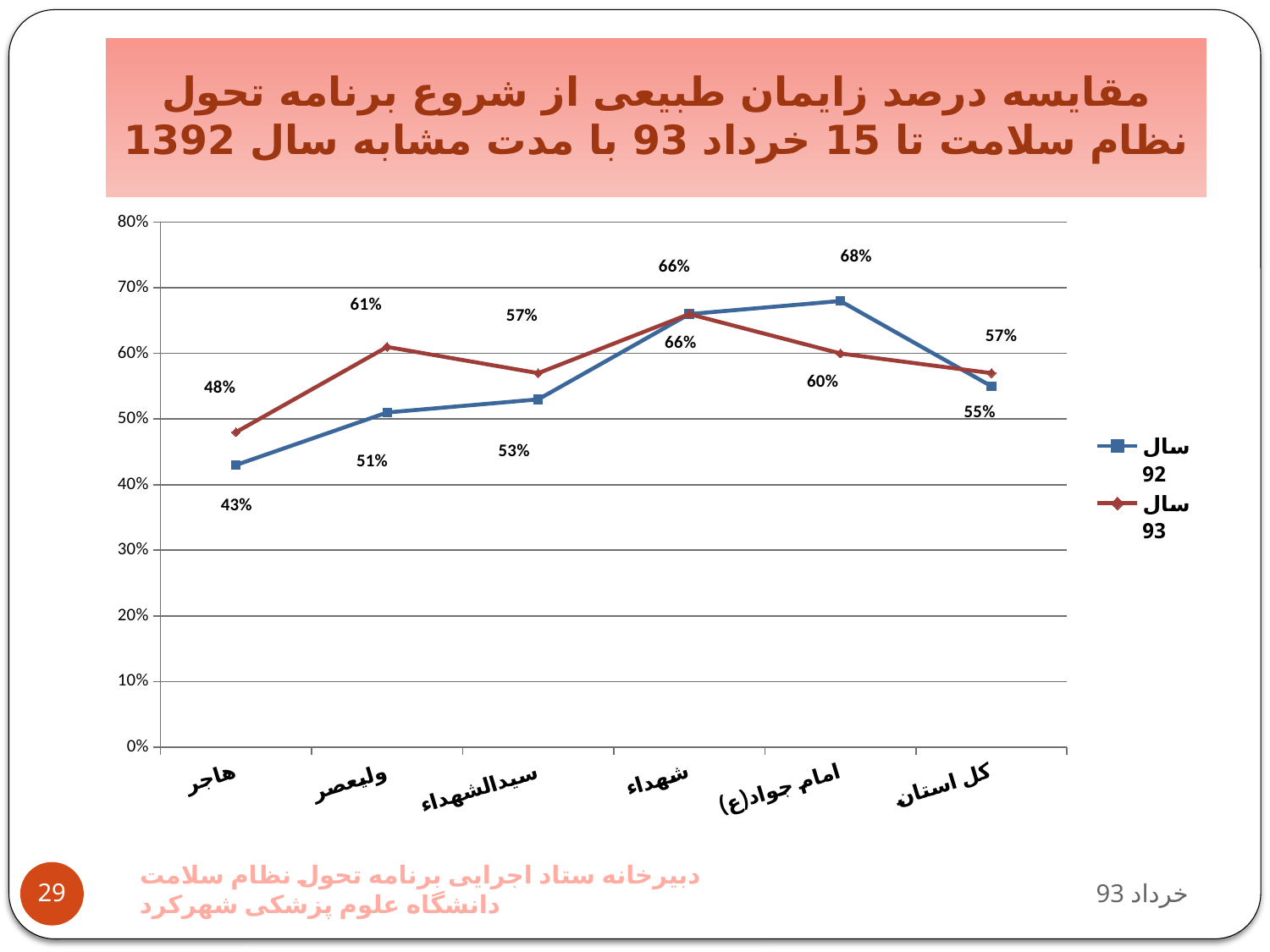
Which series is drawn in blue with square markers? سال 92 Is the value for شهداء in the سال 93 series greater or less than 60%? greater How many categories are shown on the x axis? 6 What type of chart is shown on the slide? line chart What is the value for هاجر in the سال 92 series? 43% What is the difference between the سال 92 and سال 93 values for امام جواد(ع)? 8% What is the value for ولیعصر in the سال 93 series? 61% What is the value for کل استان in the سال 92 series? 55% How many series does the legend list? 2 For سیدالشهداء, which series has the larger value, سال 92 or سال 93? سال 93 Which category has the highest value in the سال 92 series? امام جواد(ع) Which category has the lowest value in the سال 93 series? هاجر